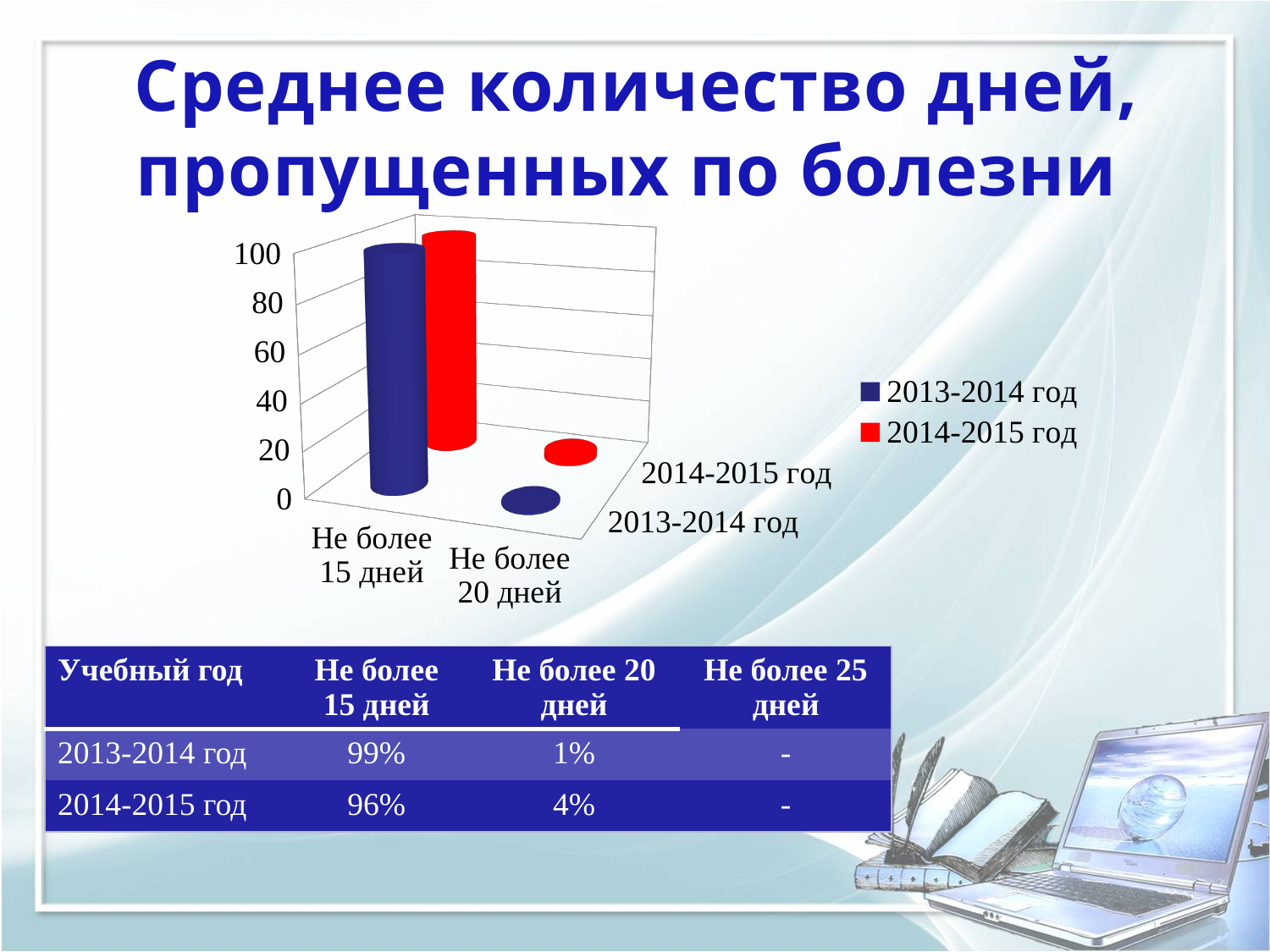
According to the table on the slide, what is the value for "Не более 20 дней" in 2013-2014 год? 1% Is the value for "Не более 15 дней" in the 2013-2014 год series greater or less than 80? greater How many series does the chart legend list? 2 Is the value for "Не более 15 дней" in the 2014-2015 год series greater or less than 60? greater Which category has the lowest value in the 2014-2015 год series? Не более 20 дней What kind of chart is shown on the slide? bar chart For the 2013-2014 год series, which category has the higher value: "Не более 15 дней" or "Не более 20 дней"? Не более 15 дней How many categories are shown on the chart's x axis? 2 According to the table on the slide, what is the value for "Не более 15 дней" in 2014-2015 год? 96% Do the values rise or fall from "Не более 15 дней" to "Не более 20 дней" in the 2013-2014 год series? fall Which series is shown in red in the chart legend? 2014-2015 год Is the value for "Не более 20 дней" in the 2014-2015 год series greater or less than 20? less